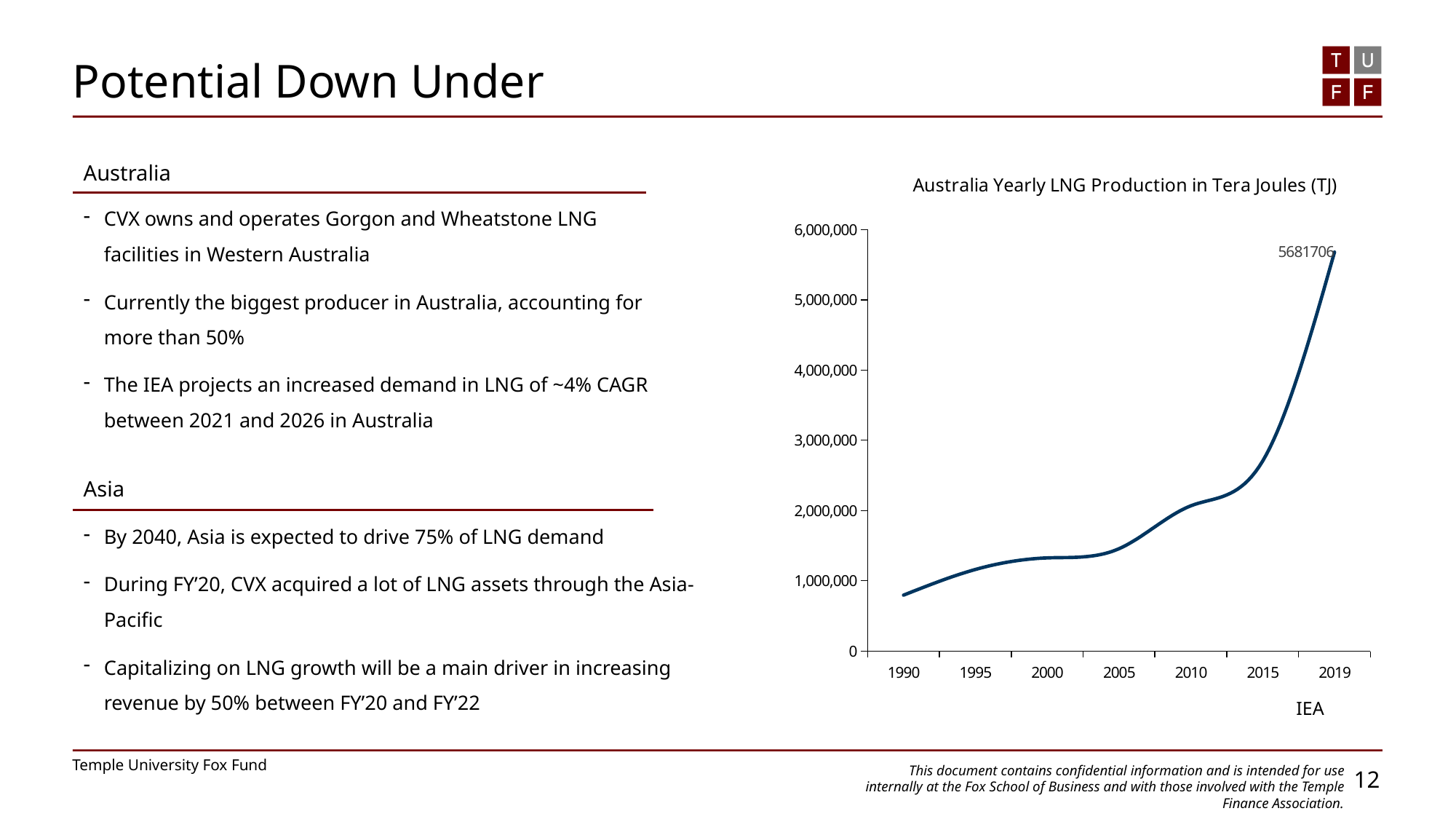
In which year shown on the x axis is Australia's LNG production highest? 2019 Is the value for 2015 greater or less than 3,000,000? less Does Australia's yearly LNG production rise or fall from 1990 to 2019? Rise What is the value of Australia's LNG production in 2019 according to the data label on the chart? 5681706 In which year shown on the x axis is Australia's LNG production lowest? 1990 What is the title of the chart on the slide? Australia Yearly LNG Production in Tera Joules (TJ) What kind of chart is used to show Australia Yearly LNG Production? Line chart Which year has the larger LNG production, 1990 or 2019? 2019 What source is cited below the chart? IEA Is the value for 1990 greater or less than 1,000,000? less Is the value for 2000 greater or less than 2,000,000? less